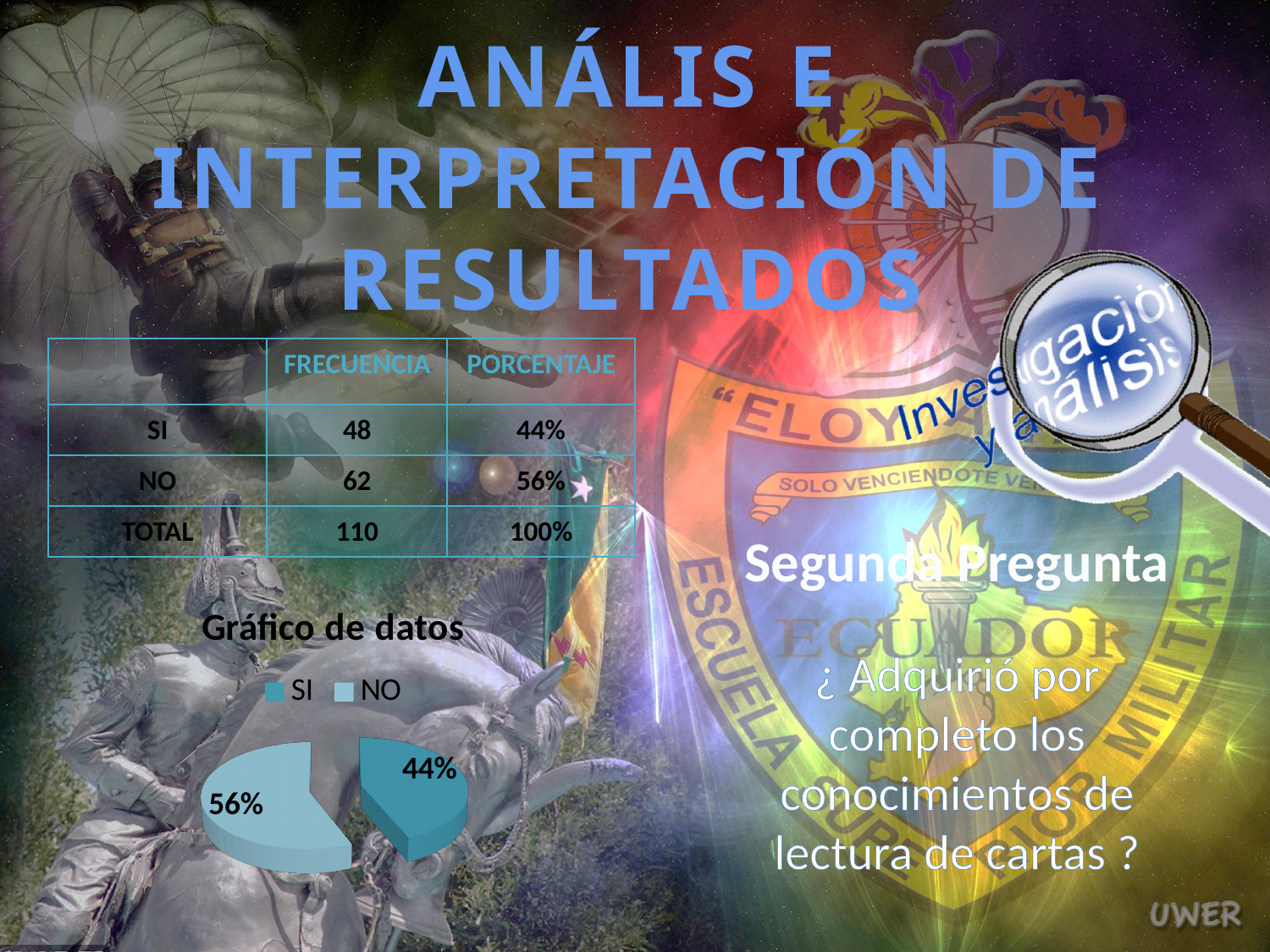
What percentage does the NO slice of the pie chart show? 56% What is the difference in percentage points between the NO slice and the SI slice of the pie chart? 12% What is the title of the pie chart? Gráfico de datos What percentage does the SI slice of the pie chart show? 44% What are the two legend entries of the pie chart? SI and NO Which slice of the pie chart is the largest? NO What type of chart is shown under the title 'Gráfico de datos'? pie chart Which is larger in the pie chart, SI or NO? NO Is the share of the NO slice in the pie chart greater or less than 50%? greater Which slice of the pie chart is the smallest? SI How many slices does the pie chart have? 2 How many entries does the legend of the pie chart list? 2